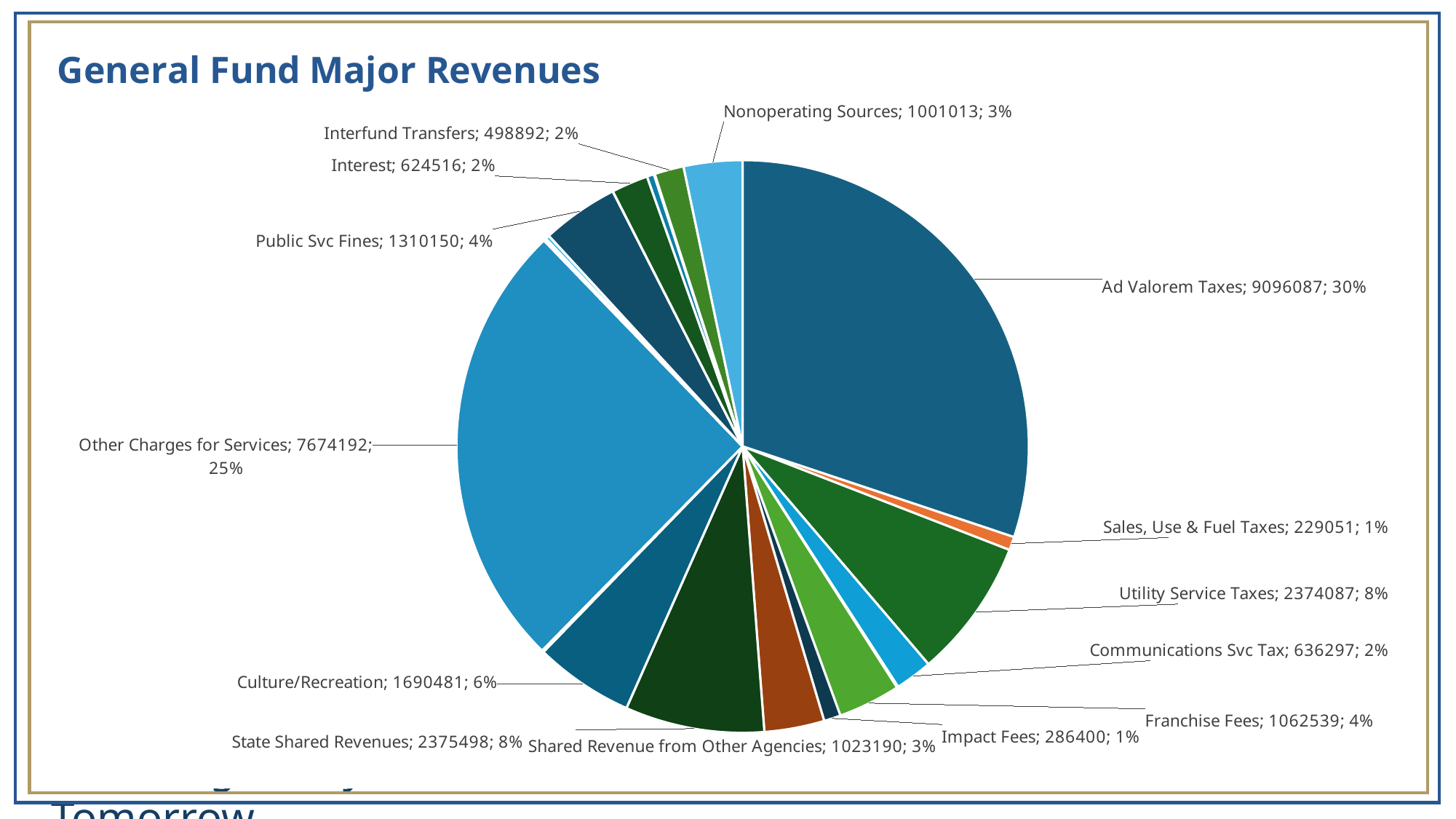
What type of chart is shown on the slide? pie chart What share of the pie does Other Charges for Services represent? 25% Which is larger, the value for Public Svc Fines or the value for Interest? Public Svc Fines What is the difference between the values for Ad Valorem Taxes and Other Charges for Services? 1421895 What is the value for Ad Valorem Taxes? 9096087 What is the title of the chart? General Fund Major Revenues What is the value for Franchise Fees? 1062539 What share of the pie does Utility Service Taxes represent? 8% What is the value for Culture/Recreation? 1690481 Which category has the largest slice of the pie? Ad Valorem Taxes